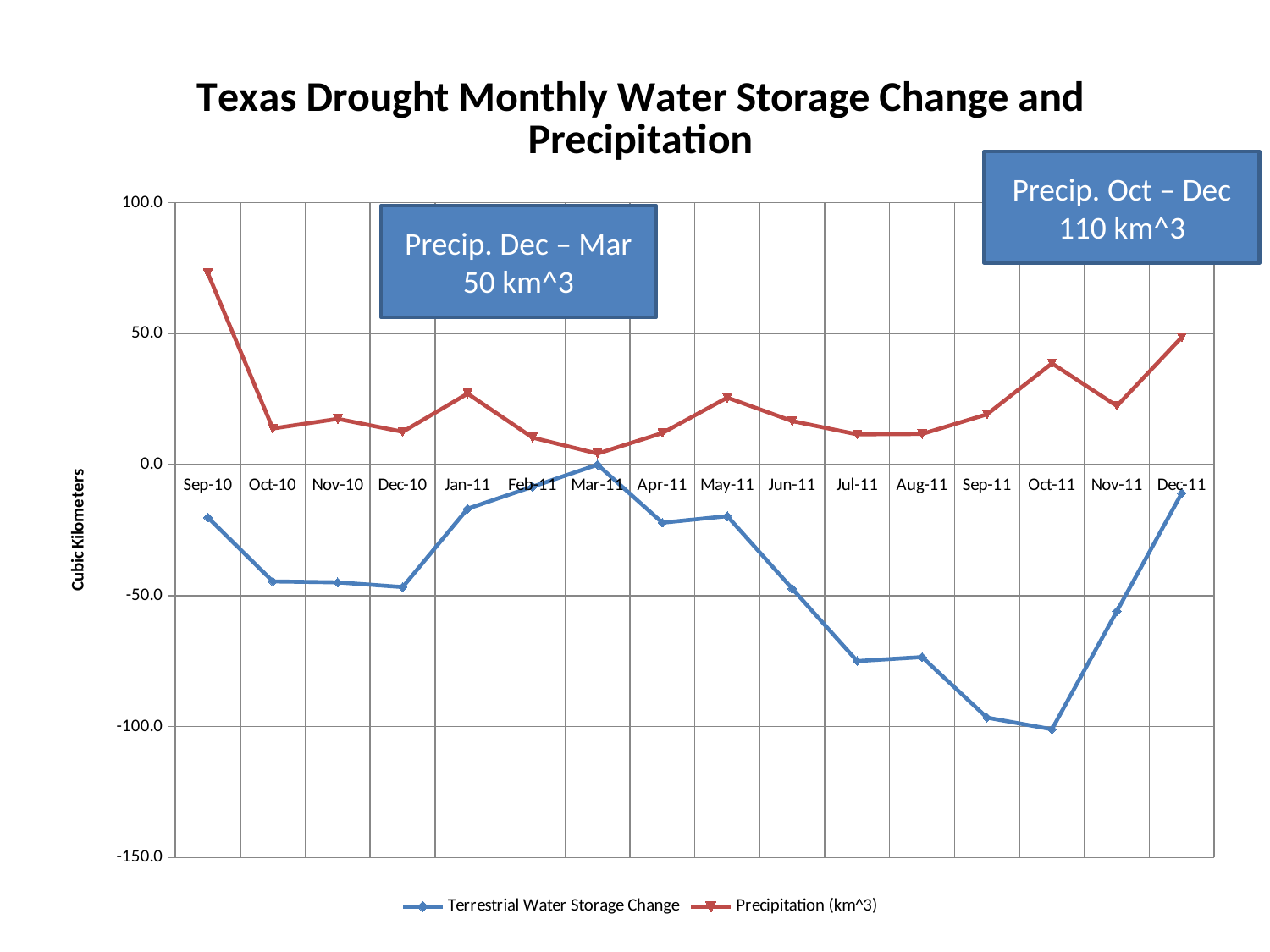
Is the Terrestrial Water Storage Change value for Sep-11 greater or less than -50? less In which month is Precipitation (km^3) lowest? Mar-11 How many series does the legend list? 2 In which month is Terrestrial Water Storage Change lowest? Oct-11 What is the label on the y axis? Cubic Kilometers Is the Precipitation (km^3) value for Oct-11 greater or less than 50? less Is the Precipitation (km^3) value for Sep-10 greater or less than 50? greater In which month is Precipitation (km^3) highest? Sep-10 Does Terrestrial Water Storage Change rise or fall from Jun-11 to Oct-11? Fall Which is larger: Terrestrial Water Storage Change in Jan-11 or in Oct-11? Jan-11 How many months are plotted along the x axis? 16 What kind of chart is shown on the slide? Line chart